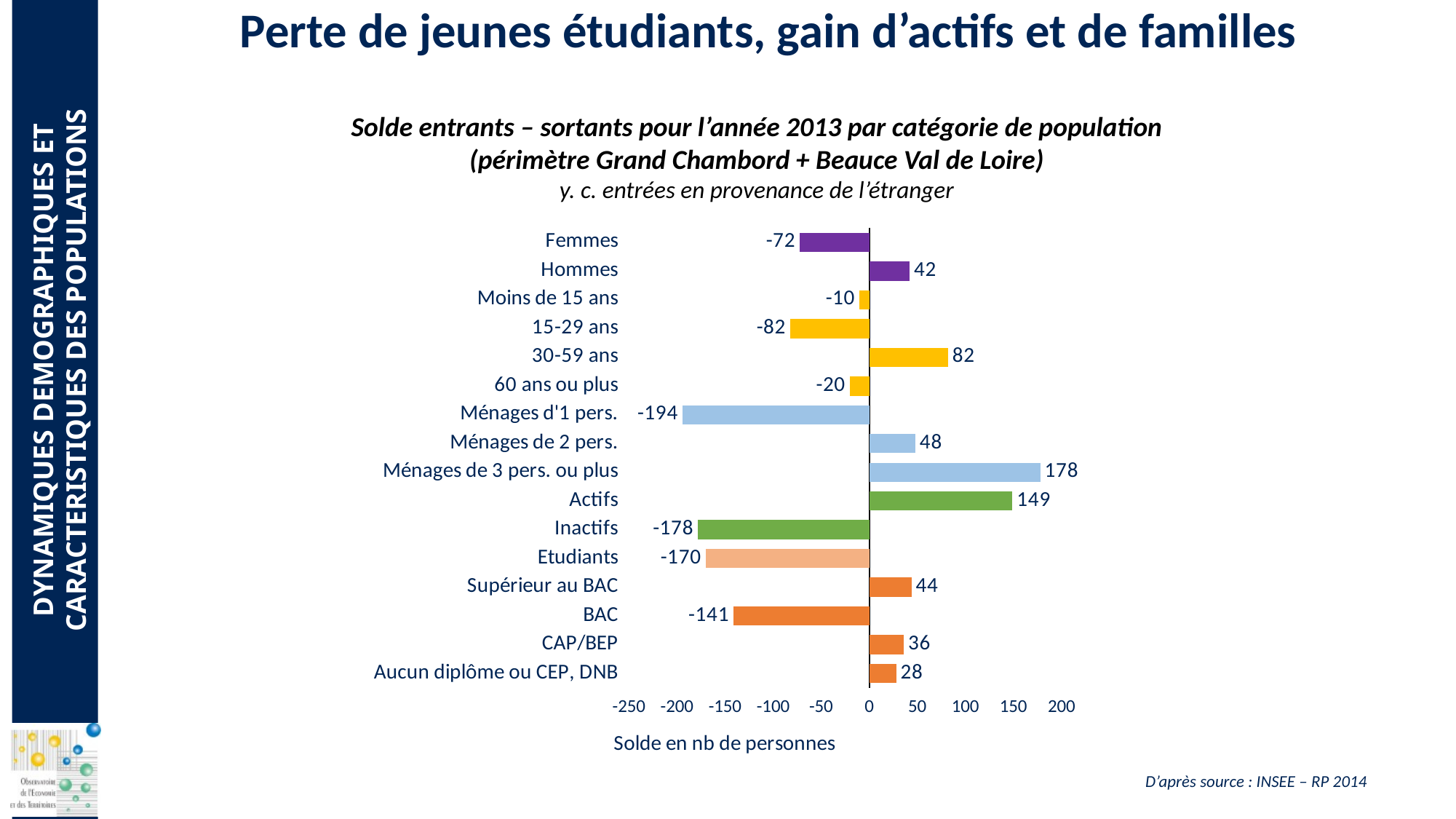
Which is larger, the value for Supérieur au BAC or the value for CAP/BEP? Supérieur au BAC What is the value for Actifs? 149 What is the value for Etudiants? -170 What is the difference between the values for Hommes and Femmes? 114 What is the label of the horizontal axis? Solde en nb de personnes Which category has the highest value? Ménages de 3 pers. ou plus What is the value for 30-59 ans? 82 What is the value for Ménages d'1 pers.? -194 Which category has the lowest value? Ménages d'1 pers. Is the value for BAC greater or less than -100? less What kind of chart is shown on the slide? bar chart How many categories are shown in the chart? 16